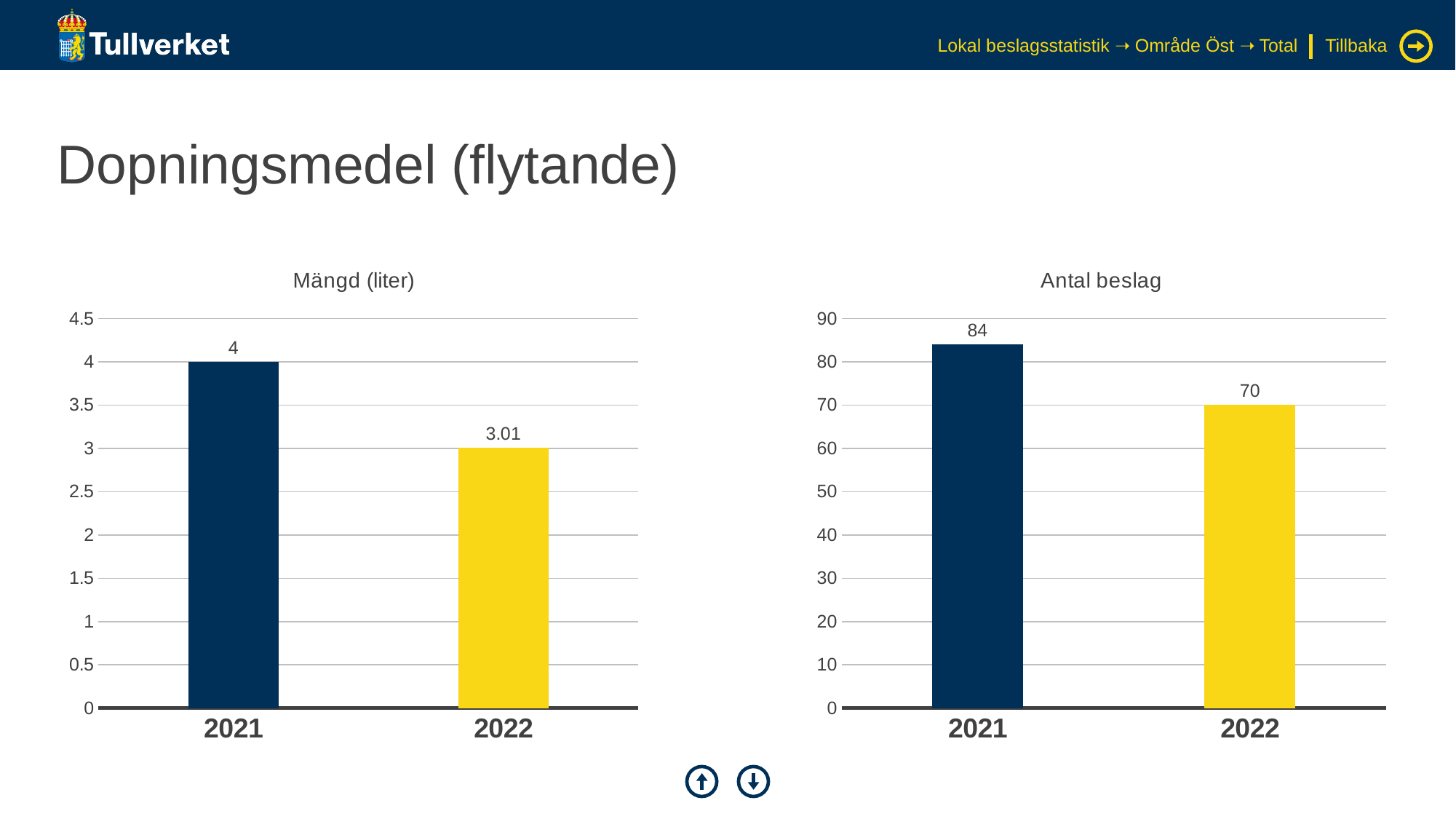
In the 'Mängd (liter)' chart, is the value for 2021 larger or smaller than the value for 2022? larger In the 'Antal beslag' chart, which year has the highest value? 2021 What kind of chart is the 'Mängd (liter)' chart? bar chart In the 'Antal beslag' chart, what is the value for 2022? 70 In the 'Mängd (liter)' chart, what is the value for 2021? 4 How many categories are shown in the 'Antal beslag' chart? 2 In the 'Antal beslag' chart, what is the value for 2021? 84 In the 'Antal beslag' chart, is the value for 2022 greater or less than 80? less In the 'Mängd (liter)' chart, what is the difference between the 2021 and 2022 values? 0.99 In the 'Mängd (liter)' chart, what is the value for 2022? 3.01 In the 'Antal beslag' chart, what is the difference between the 2021 and 2022 values? 14 In the 'Mängd (liter)' chart, which year has the lowest value? 2022